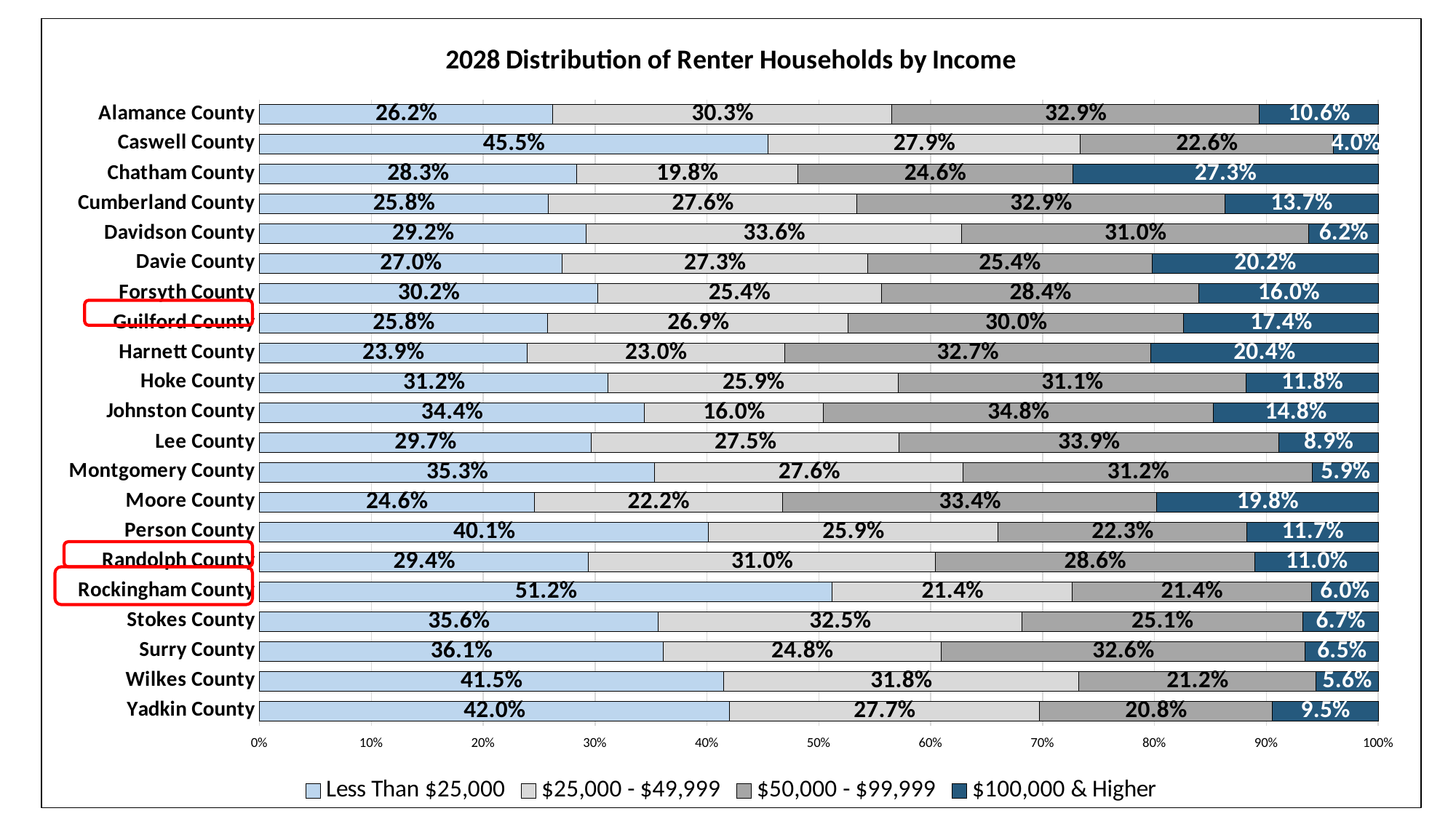
What is the $100,000 & Higher value for Chatham County? 27.3% What kind of chart is shown on the slide? Stacked bar chart Which three county labels are circled in red on the slide? Guilford County, Randolph County, Rockingham County What is the title of the chart? 2028 Distribution of Renter Households by Income What is the difference in percentage points between the Less Than $25,000 shares of Rockingham County and Caswell County? 5.7 How many counties are shown in the chart? 21 Which county has the highest share of renter households earning less than $25,000? Rockingham County How many series does the legend list? 4 What is the $25,000 - $49,999 value for Davidson County? 33.6% What share of renter households in Rockingham County earn less than $25,000? 51.2% Which county has the lowest share of renter households earning $100,000 & Higher? Caswell County Which has a larger $50,000 - $99,999 share, Guilford County or Randolph County? Guilford County